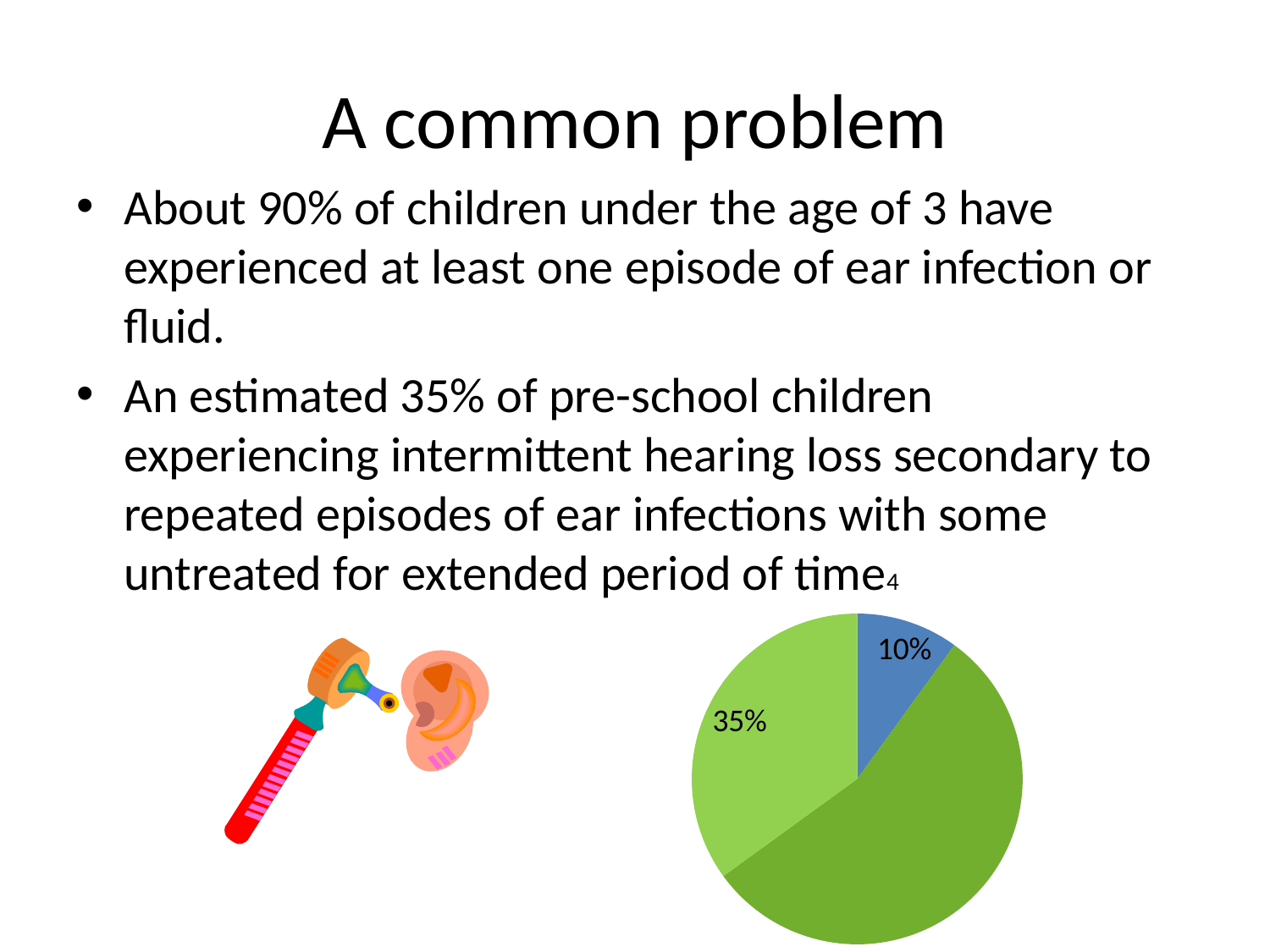
What is the difference between the light green slice (35%) and the blue slice (10%) in the pie chart? 25% Does the unlabelled dark green slice take up more or less than half of the pie chart? More How many slices of the pie chart have a percentage label printed on them? 2 What value is labelled on the light green slice of the pie chart? 35% What do the two labelled slices of the pie chart (10% and 35%) add up to? 45% What kind of chart is shown at the bottom right of the slide? Pie chart What value is labelled on the blue slice of the pie chart? 10% Which slice of the pie chart is the largest? The dark green slice Which is larger in the pie chart, the blue slice or the light green slice? The light green slice Does the pie chart include a legend? No Which slice of the pie chart is the smallest? The blue slice (10%) How many slices does the pie chart have? 3